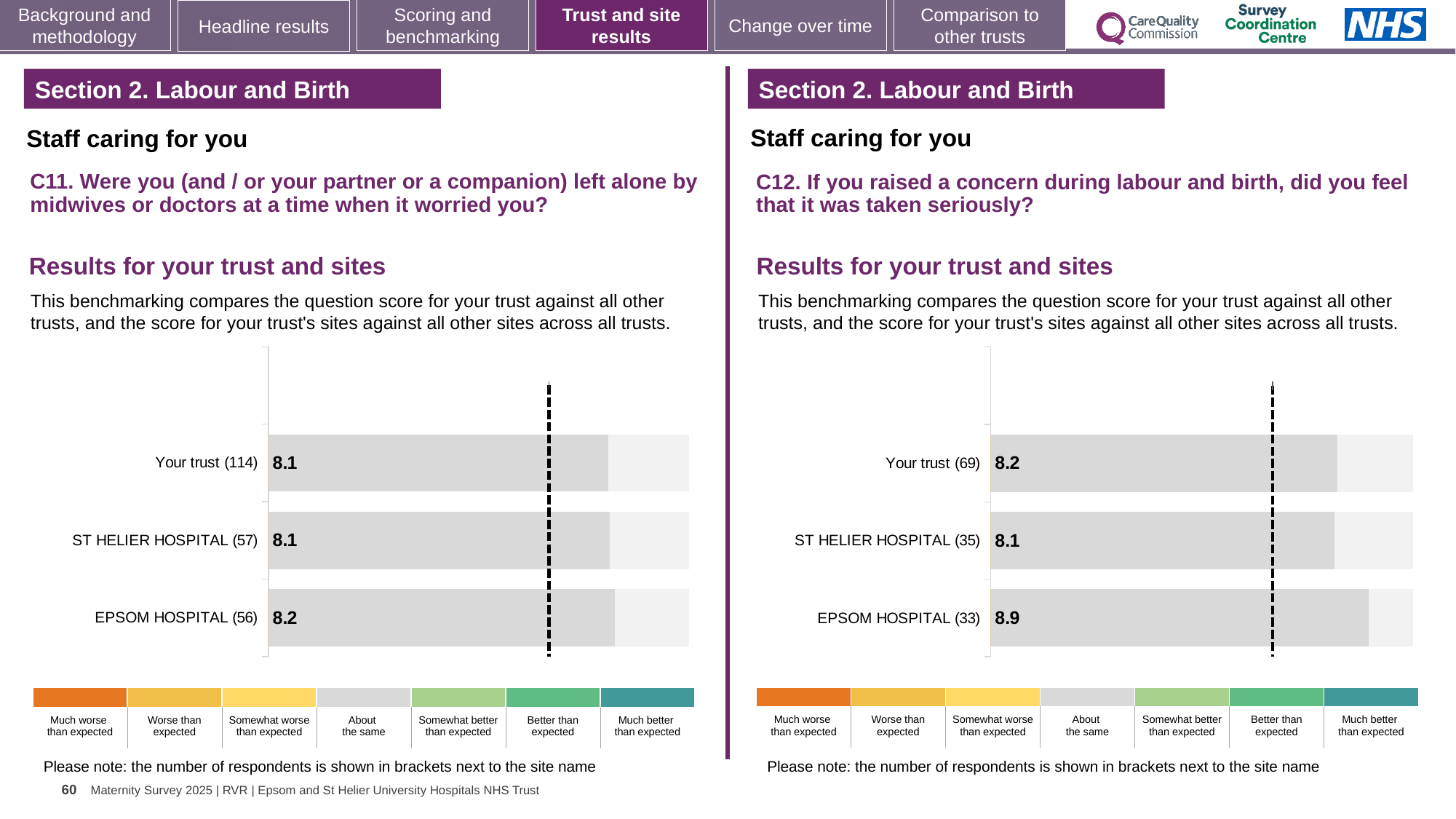
How many bars are shown in the C11 chart on the left? 3 In the C11 chart on the left, what is the score for EPSOM HOSPITAL? 8.2 In the C12 chart on the right, which site or trust has the highest score? EPSOM HOSPITAL In the C12 chart on the right, what is the score for ST HELIER HOSPITAL? 8.1 In the C11 chart on the left, what is the score for Your trust? 8.1 In the C12 chart on the right, what is the score for EPSOM HOSPITAL? 8.9 In the C12 chart on the right, which has the larger score, Your trust or EPSOM HOSPITAL? EPSOM HOSPITAL In the C12 chart on the right, how many respondents are shown in brackets for EPSOM HOSPITAL? 33 In the C12 chart on the right, which site or trust has the lowest score? ST HELIER HOSPITAL In the C12 chart on the right, what is the difference between the scores for EPSOM HOSPITAL and ST HELIER HOSPITAL? 0.8 In the C11 chart on the left, how many respondents are shown in brackets for Your trust? 114 What type of chart is used in the C11 chart on the left? Bar chart